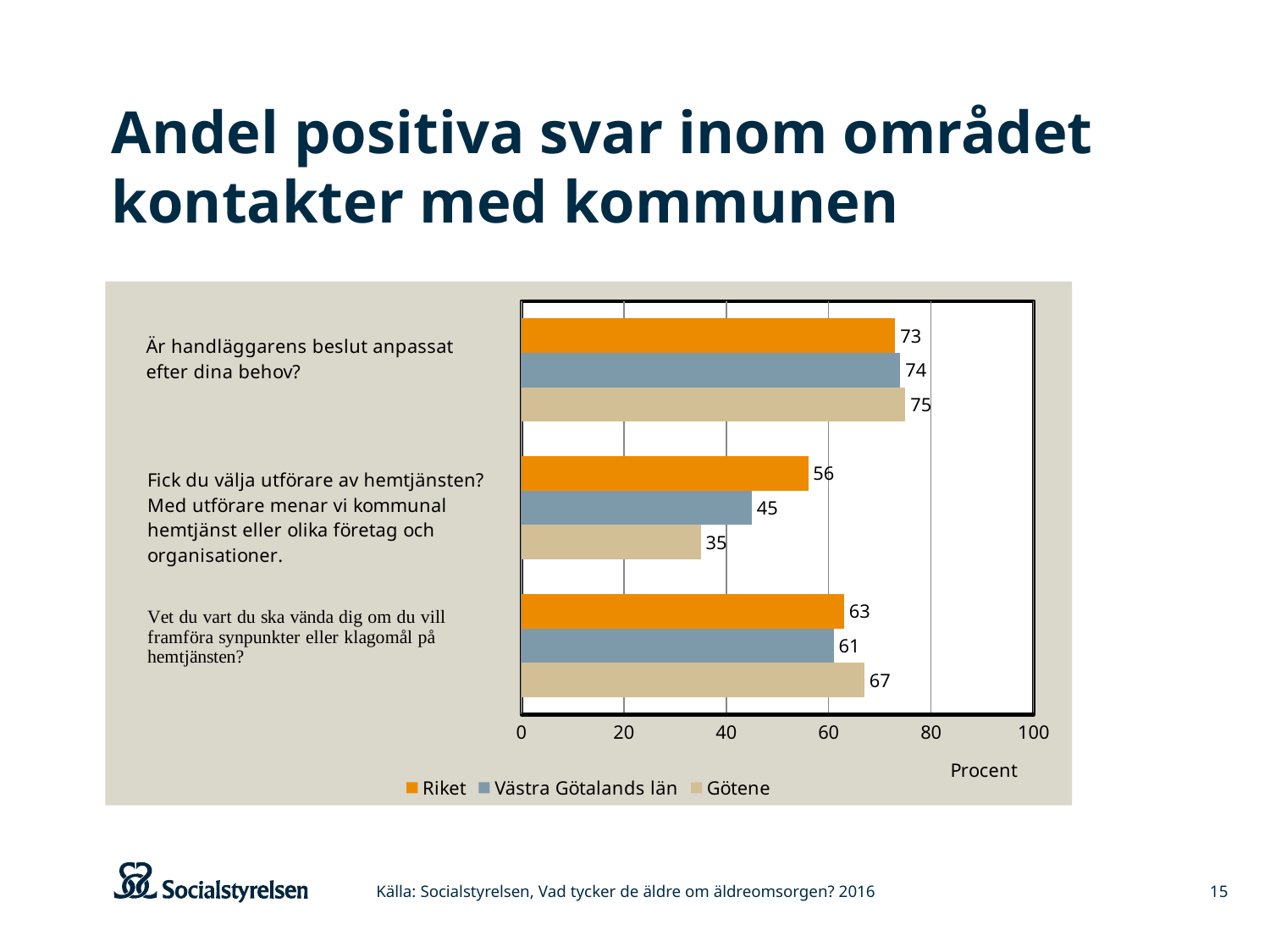
What is the difference between Riket and Götene on "Fick du välja utförare av hemtjänsten?"? 21 What unit is shown on the horizontal axis of the chart? Procent How many series does the legend list? 3 What kind of chart is shown on the slide? Bar chart Which series has the lowest value on "Vet du vart du ska vända dig om du vill framföra synpunkter eller klagomål på hemtjänsten?"? Västra Götalands län Which series has the highest value on "Fick du välja utförare av hemtjänsten?"? Riket What is the value for Västra Götalands län on "Vet du vart du ska vända dig om du vill framföra synpunkter eller klagomål på hemtjänsten?"? 61 Which is larger on "Är handläggarens beslut anpassat efter dina behov?": Riket or Götene? Götene What is the difference between Götene and Riket on "Vet du vart du ska vända dig om du vill framföra synpunkter eller klagomål på hemtjänsten?"? 4 What is the value for Riket on "Är handläggarens beslut anpassat efter dina behov?"? 73 What is the value for Götene on "Fick du välja utförare av hemtjänsten?"? 35 How many question categories are shown in the chart? 3